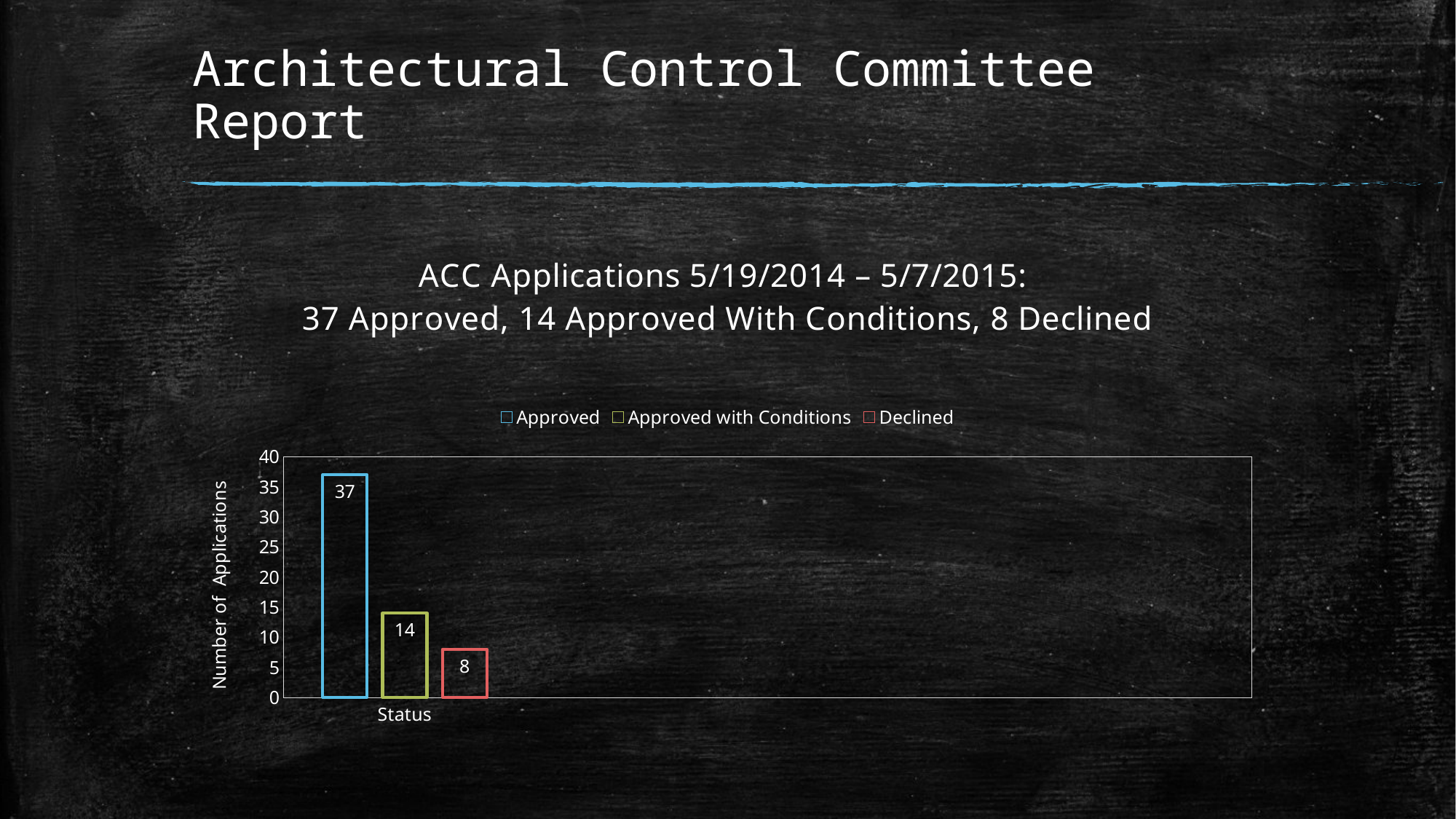
Which is larger, the number of Approved with Conditions applications or the number of Declined applications? Approved with Conditions Which series has the highest number of applications? Approved How many series does the legend list? 3 Which series has the lowest number of applications? Declined How many applications were Declined? 8 Is the value for Approved greater or less than 35? greater What is the difference between the number of Approved applications and the number of Declined applications? 29 What is the label of the vertical axis of the chart? Number of Applications What kind of chart is shown on the slide? bar chart How many applications were Approved with Conditions? 14 What is the difference between Approved with Conditions and Declined applications? 6 How many applications were Approved? 37